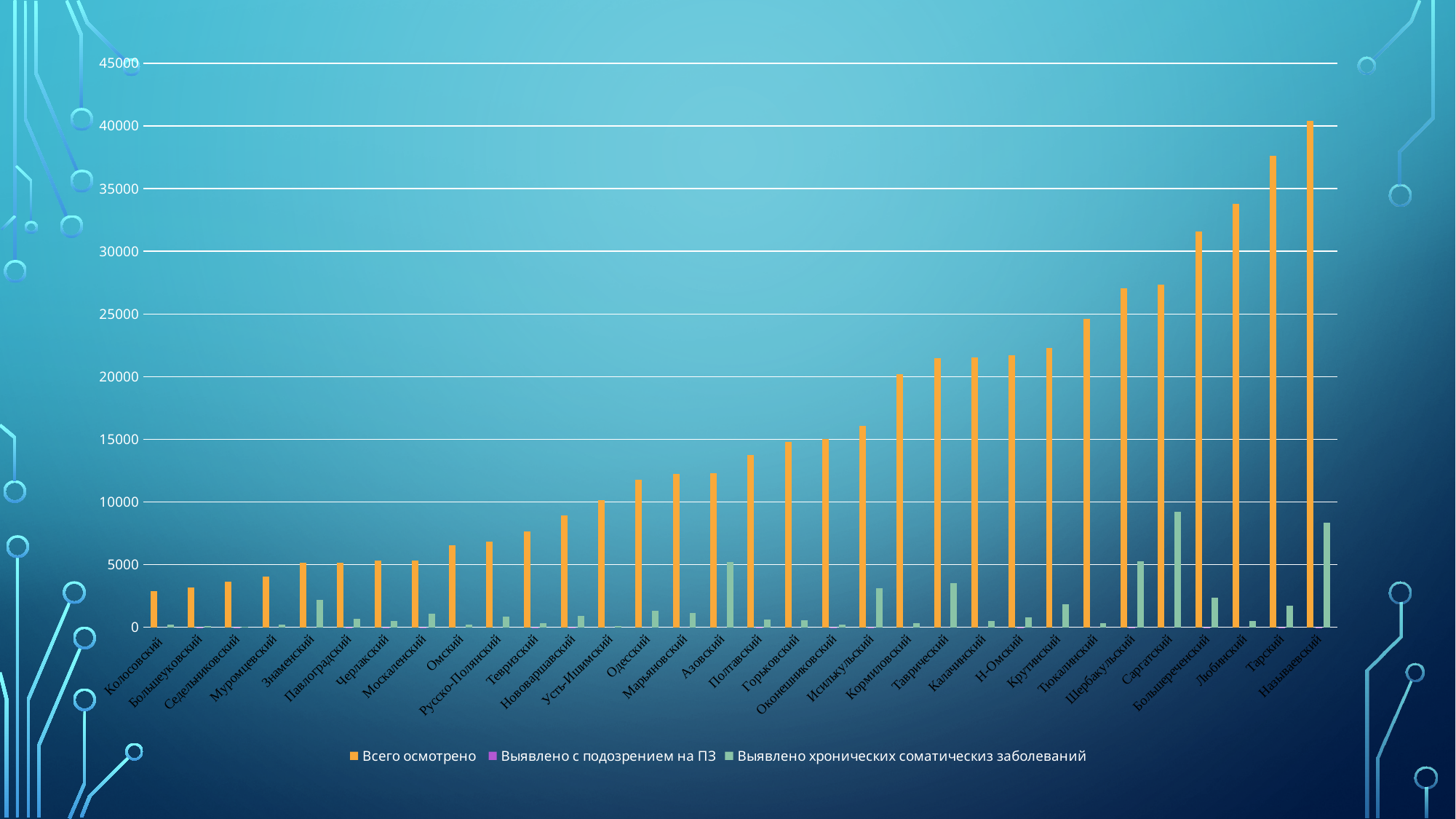
Is the value of Выявлено хронических соматическиз заболеваний for Саргатский greater or less than 5000? greater How many series does the legend list? 3 Which district has the highest value for Всего осмотрено? Называевский Is the value of Всего осмотрено for Колосовский greater or less than 5000? less Is the value of Всего осмотрено for Тарский greater or less than 35000? greater What kind of chart is shown on the slide? bar chart Which district has the highest value for Выявлено хронических соматическиз заболеваний? Саргатский How many districts (categories) are shown on the x axis? 32 Which district has a larger value for Всего осмотрено, Тарский or Любинский? Тарский Which district has the lowest value for Всего осмотрено? Колосовский Do the values of Всего осмотрено rise or fall from left to right along the x axis? rise